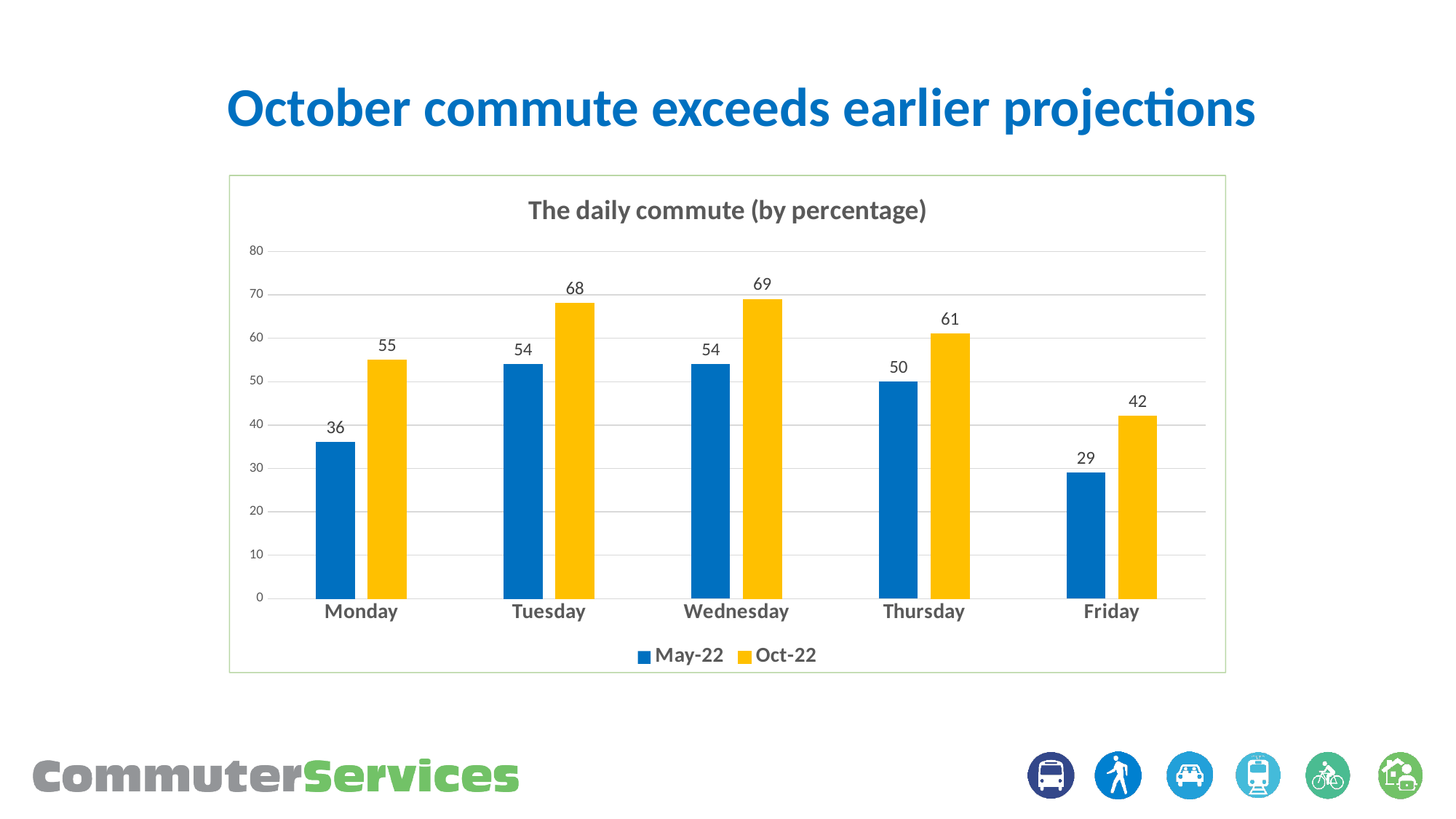
Which day has the lowest May-22 value? Friday Which day has the highest Oct-22 value? Wednesday What is the difference between the Oct-22 values for Tuesday and Friday? 26 What is the difference between the Oct-22 and May-22 values for Monday? 19 What is the Oct-22 value for Wednesday? 69 What is the title of the chart? The daily commute (by percentage) How many days are shown on the x axis? 5 Which is larger, the May-22 value for Thursday or the May-22 value for Monday? Thursday How many series does the legend list? 2 What is the May-22 value for Friday? 29 What kind of chart is shown on the slide? Bar chart What is the Oct-22 value for Monday? 55